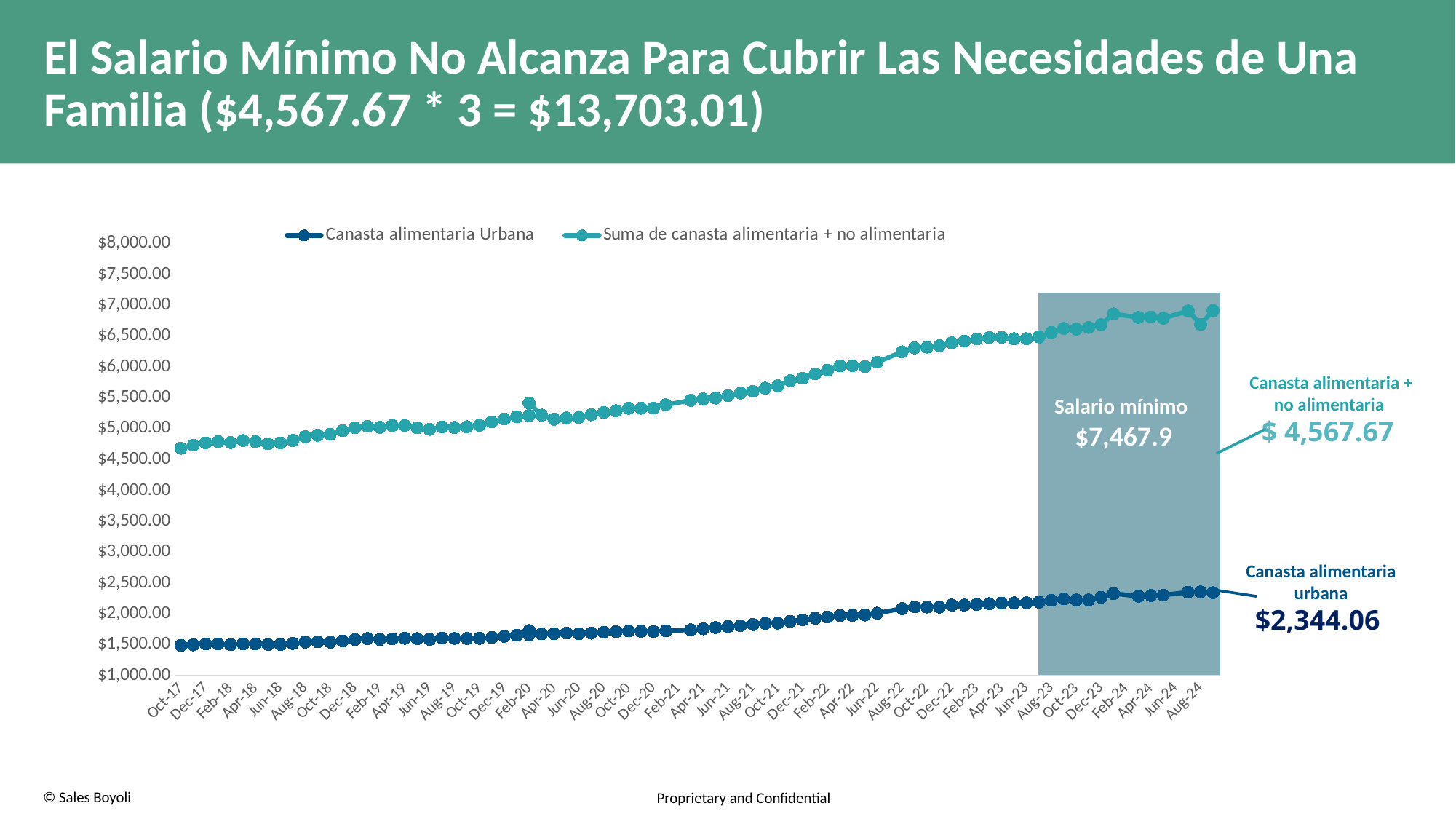
What is the difference between the labelled Canasta alimentaria + no alimentaria value ($ 4,567.67) and the labelled Canasta alimentaria urbana value ($2,344.06)? $2,223.61 Is the value of the Suma de canasta alimentaria + no alimentaria series at Aug-24 greater or less than $6,500.00? greater Do the values of the Suma de canasta alimentaria + no alimentaria series generally rise or fall from Oct-17 to Aug-24? rise Is the value of the Canasta alimentaria Urbana series at Oct-17 greater or less than $2,000.00? less Is the value of the Suma de canasta alimentaria + no alimentaria series at Oct-17 greater or less than $5,000.00? less Which series has higher values throughout the chart, Canasta alimentaria Urbana or Suma de canasta alimentaria + no alimentaria? Suma de canasta alimentaria + no alimentaria What are the two series named in the chart legend? Canasta alimentaria Urbana; Suma de canasta alimentaria + no alimentaria What is the latest labelled value for the Canasta alimentaria urbana series? $2,344.06 How many series does the chart legend list? 2 What kind of chart is shown on the slide? line chart What is the latest labelled value for the Canasta alimentaria + no alimentaria series? $ 4,567.67 What Salario mínimo value is shown in the shaded region of the chart? $7,467.9